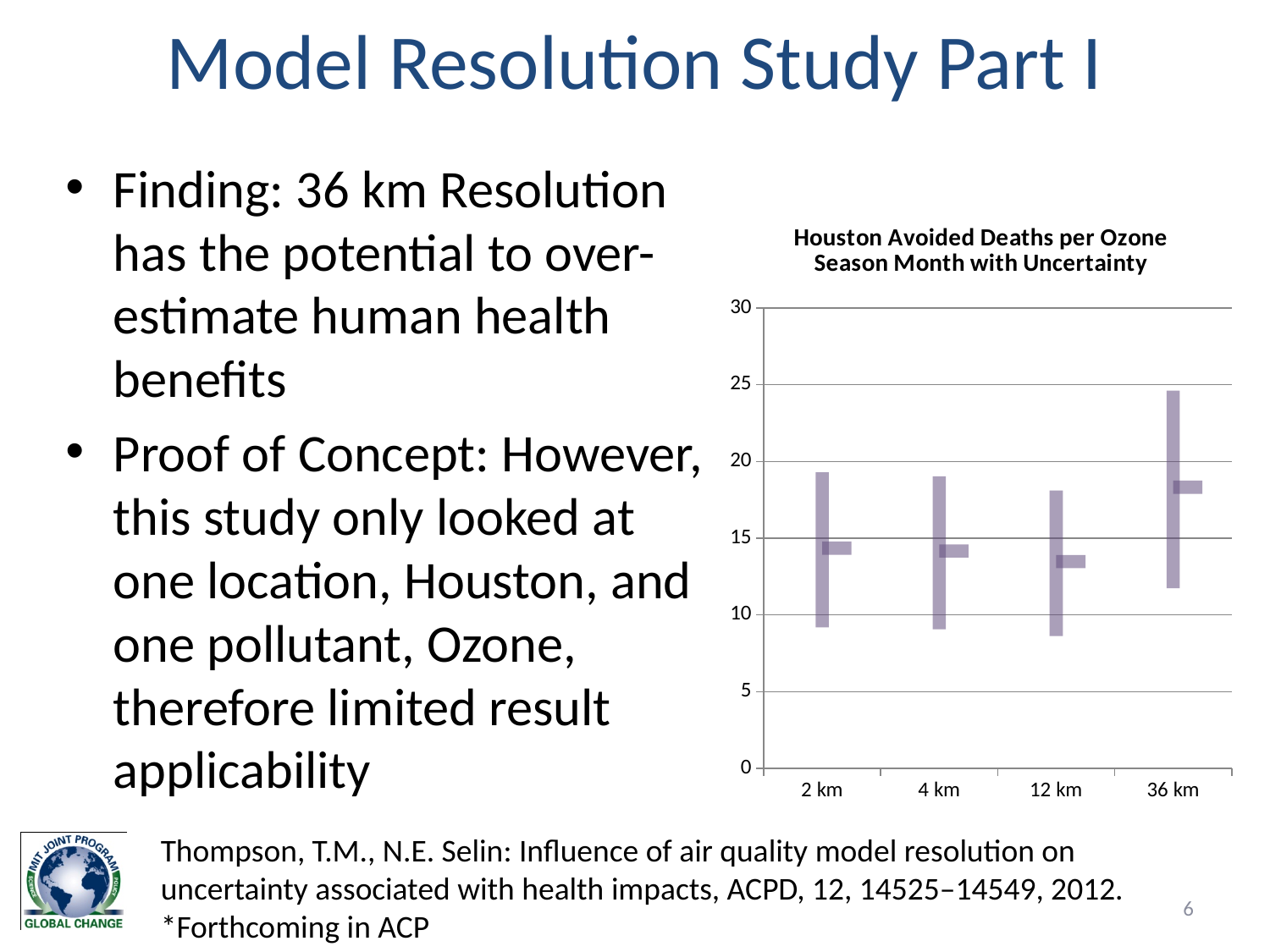
Is the central estimate for 12 km greater or less than 15? less Is the lower end of the uncertainty range for 12 km greater or less than 10? less Which resolution has the highest central estimate of avoided deaths? 36 km What is the title of the chart? Houston Avoided Deaths per Ozone Season Month with Uncertainty Is the central estimate for 2 km greater or less than 15? less What is the highest value labelled on the y axis of the chart? 30 How many resolution categories are shown on the x axis of the chart? 4 Which has the larger central estimate, 36 km or 2 km? 36 km